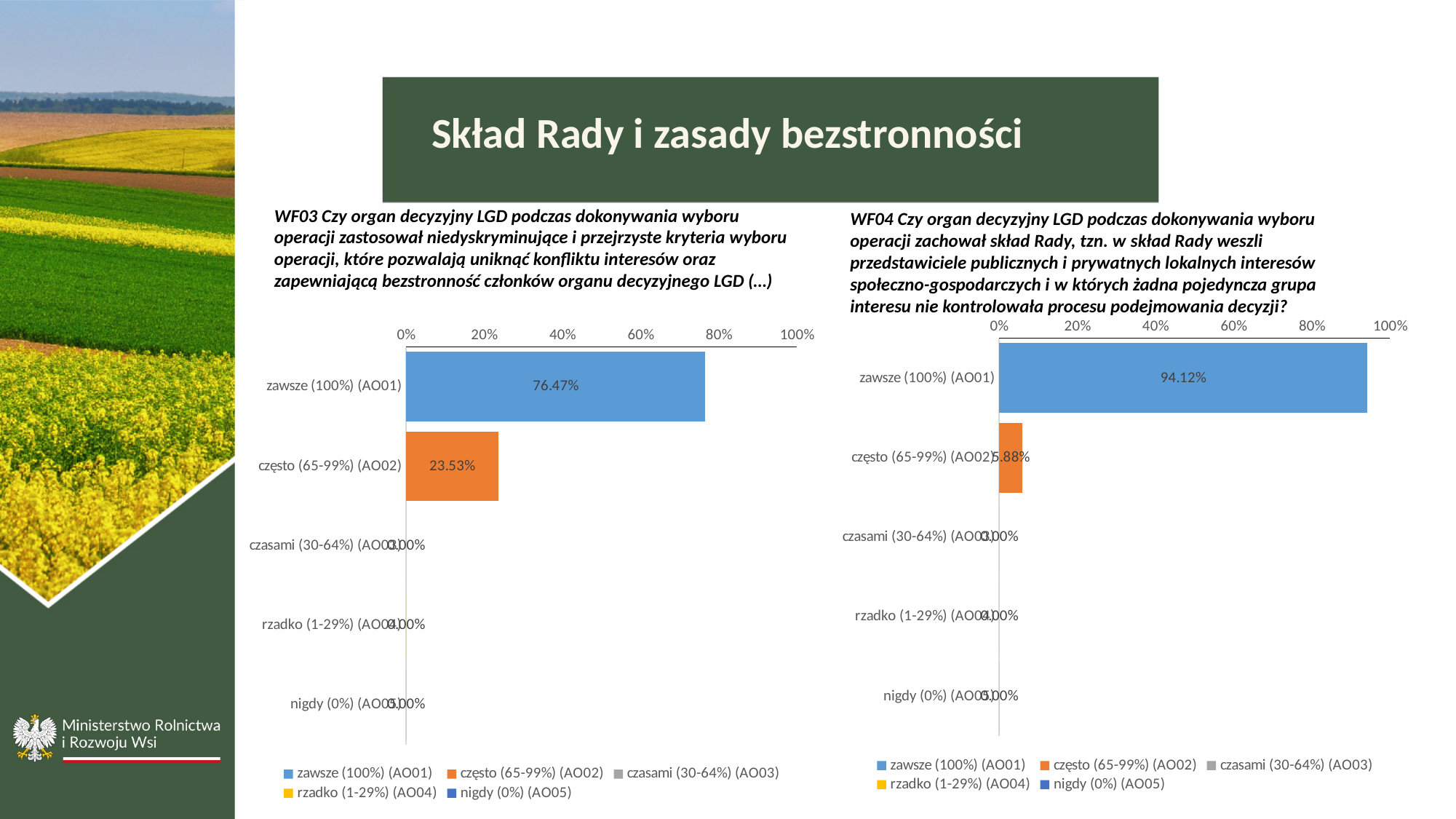
In the left chart (WF03), what is the difference between the values for 'zawsze (100%) (AO01)' and 'często (65-99%) (AO02)'? 52.94% In the right chart (WF04), what is the value for 'często (65-99%) (AO02)'? 5.88% In the left chart (WF03), which category has the highest value? zawsze (100%) (AO01) What type of chart is the left chart (WF03)? bar chart In the right chart (WF04), which category has the highest value? zawsze (100%) (AO01) In the left chart (WF03), what is the value for 'często (65-99%) (AO02)'? 23.53% How many entries does the legend of the right chart (WF04) list? 5 How many categories are shown in the left chart (WF03)? 5 In the left chart (WF03), what is the value for 'zawsze (100%) (AO01)'? 76.47% Which chart has the larger value for 'zawsze (100%) (AO01)', the left chart (WF03) or the right chart (WF04)? the right chart (WF04) In the right chart (WF04), what is the difference between the values for 'zawsze (100%) (AO01)' and 'często (65-99%) (AO02)'? 88.24% In the right chart (WF04), what is the value for 'zawsze (100%) (AO01)'? 94.12%